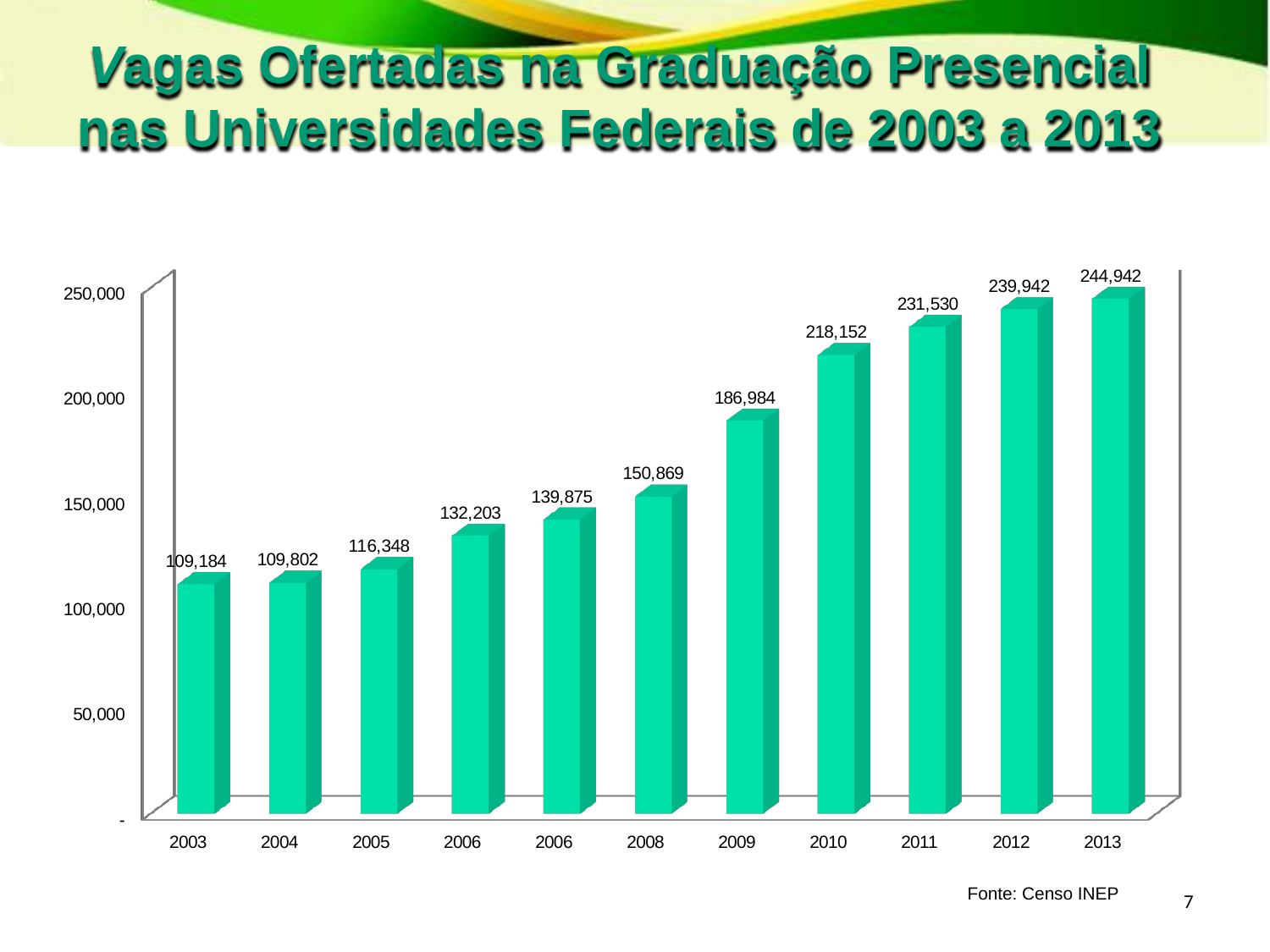
Which is larger, the value for 2004 or the value for 2005? 2005 What value is shown for 2013? 244,942 What value is shown for 2003? 109,184 Is the value for 2008 greater or less than 200,000? less Which year has the highest value? 2013 How many bars are plotted in the chart? 11 Which year has the lowest value? 2003 What is the difference between the values for 2013 and 2003? 135,758 What value is shown for 2009? 186,984 What is the difference between the values for 2010 and 2009? 31,168 What value is shown for 2011? 231,530 Do the values generally rise or fall from left to right along the x axis? rise